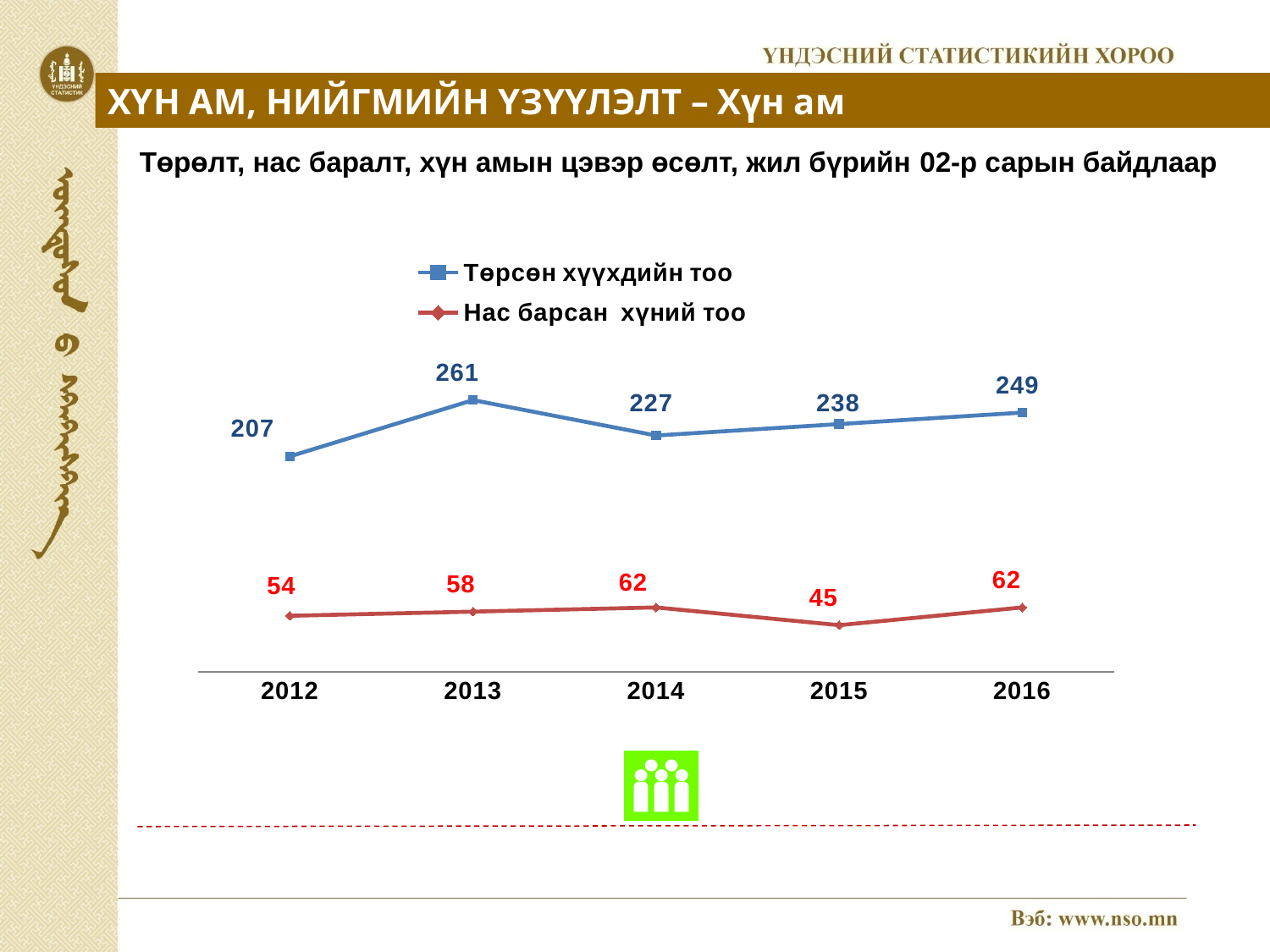
What kind of chart is shown on the slide? Line chart What is the value for Нас барсан хүний тоо in 2015? 45 In which year is Нас барсан хүний тоо lowest? 2015 In which year is Төрсөн хүүхдийн тоо lowest? 2012 What is the difference between Төрсөн хүүхдийн тоо in 2013 and in 2014? 34 What is the value for Төрсөн хүүхдийн тоо in 2016? 249 In which year is Төрсөн хүүхдийн тоо highest? 2013 What is the value for Төрсөн хүүхдийн тоо in 2013? 261 What is the difference between Төрсөн хүүхдийн тоо and Нас барсан хүний тоо in 2012? 153 Which is larger: Нас барсан хүний тоо in 2014 or in 2015? 2014 How many years are shown on the x axis? 5 How many series does the legend list? 2